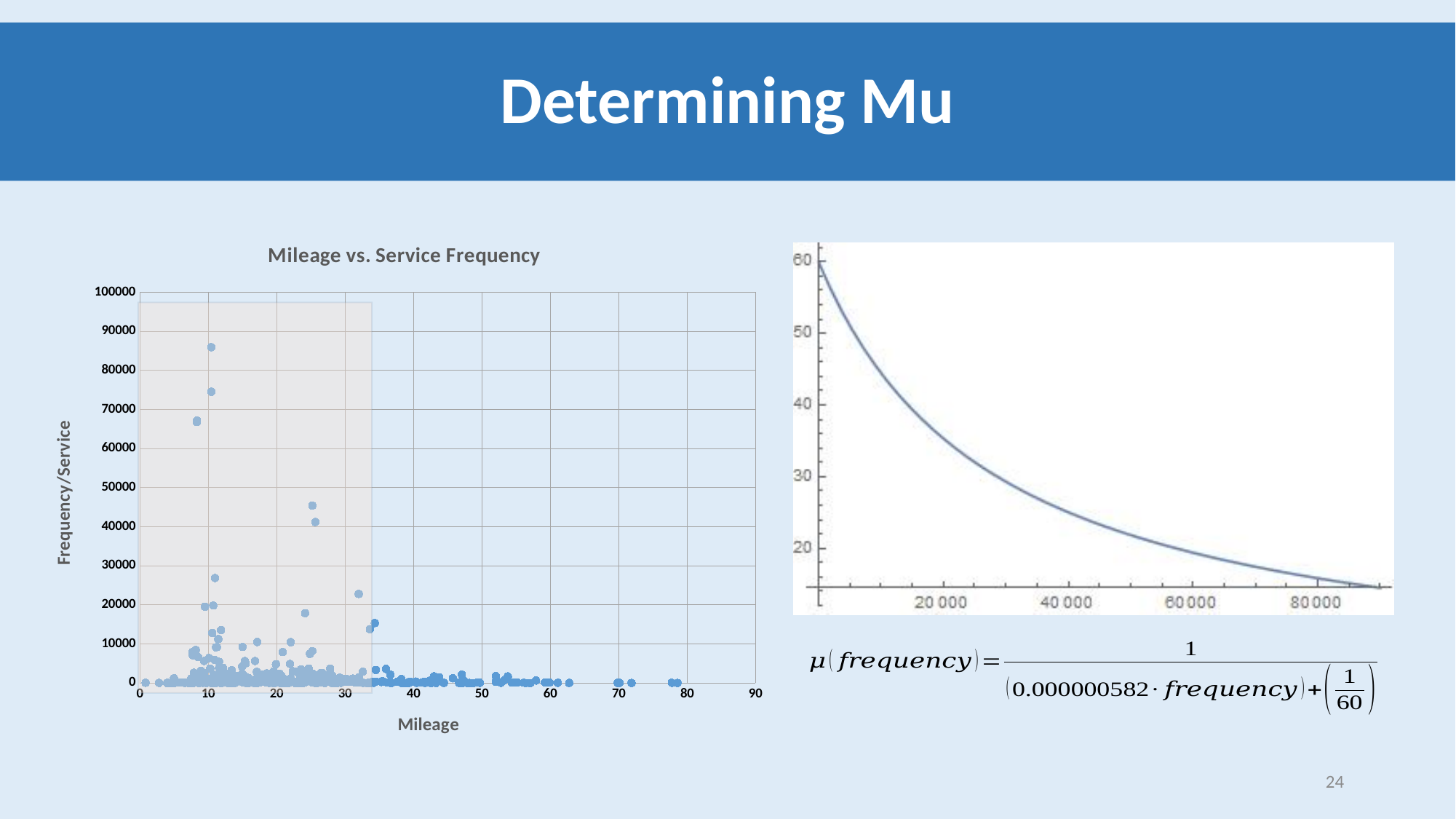
In the 'Mileage vs. Service Frequency' chart, what is the largest value shown on the horizontal axis? 90 In the 'Mileage vs. Service Frequency' chart, do the points with mileage above 40 have frequency values greater or less than 10000? less In the chart on the right of the slide, is the value of the curve at x = 40 000 greater or less than 30? less In the chart on the right of the slide, what is the largest value shown on the vertical axis? 60 In the 'Mileage vs. Service Frequency' chart, what is the label of the vertical axis? Frequency/Service What is the title of the chart on the left of the slide? Mileage vs. Service Frequency In the chart on the right of the slide, is the value of the curve at x = 80 000 greater or less than 20? less In the chart on the right of the slide, does the curve rise or fall as the x value increases? fall In the 'Mileage vs. Service Frequency' chart, what is the largest value shown on the vertical axis? 100000 What kind of chart is the 'Mileage vs. Service Frequency' chart on the left? scatter chart What kind of chart is shown on the right of the slide? line chart